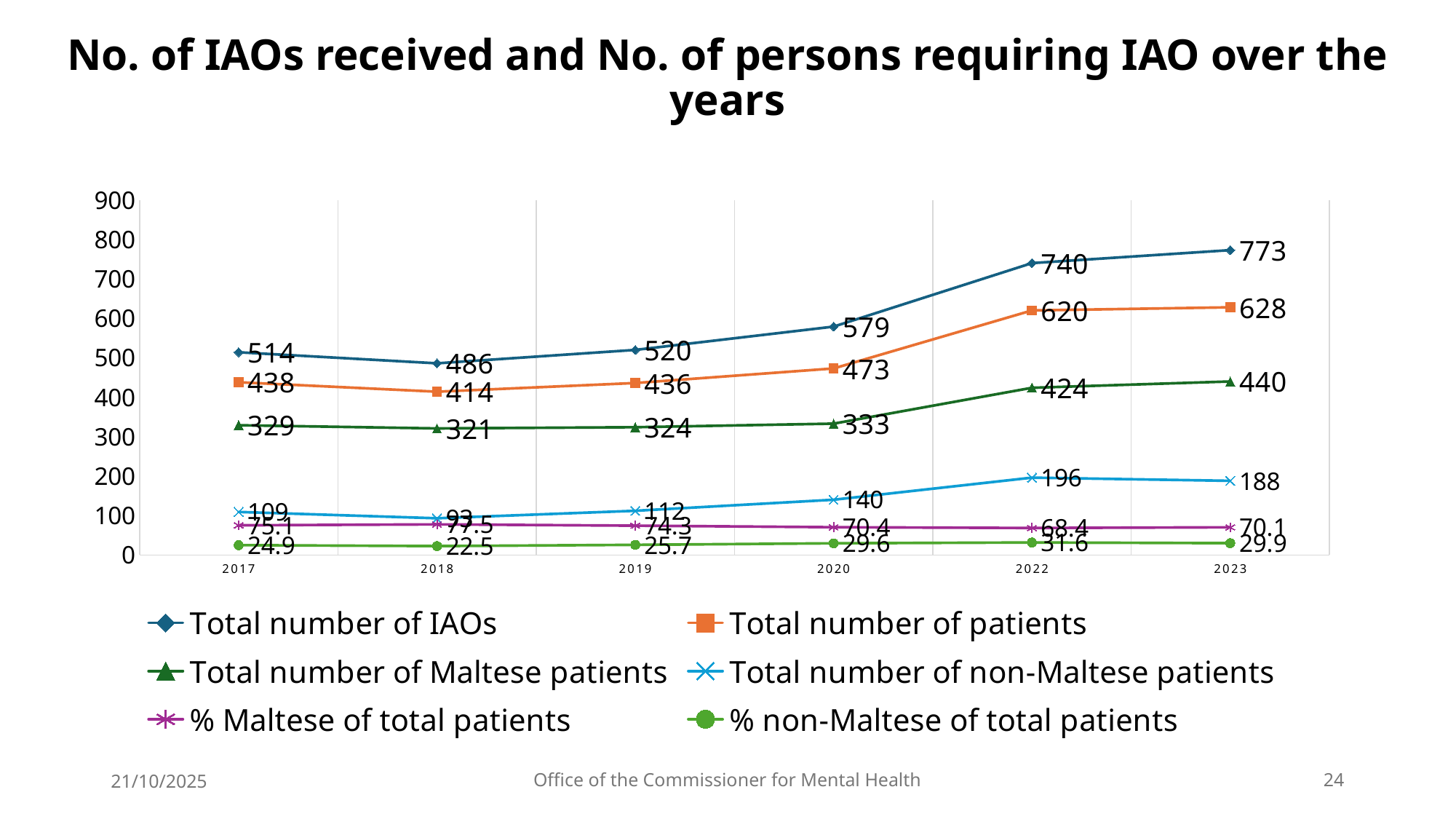
In which year is the total number of non-Maltese patients highest? 2022 How many series does the legend list? 6 How many years are shown on the x axis? 6 Which is larger: the total number of Maltese patients in 2020 or in 2022? 2022 What is the total number of patients in 2020? 473 In which year is the total number of IAOs lowest? 2018 What is the difference between the total number of IAOs and the total number of patients in 2023? 145 What is the total number of non-Maltese patients in 2019? 112 What is the total number of IAOs in 2023? 773 What is the total number of Maltese patients in 2022? 424 What is the % non-Maltese of total patients in 2022? 31.6 What kind of chart is shown on the slide? Line chart